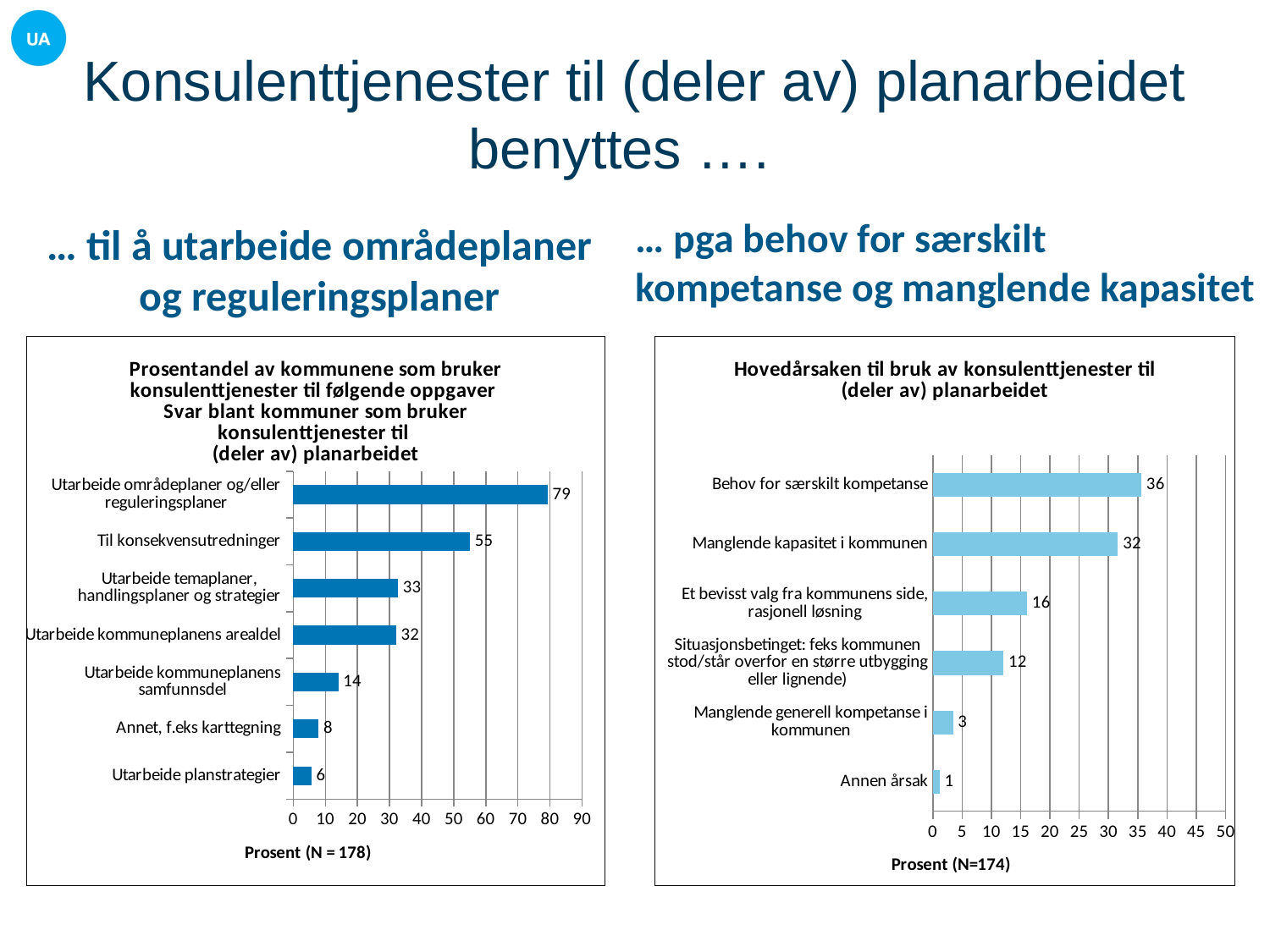
In the right chart, which category has the lowest value? Annen årsak What kind of chart is the right chart? Bar chart In the left chart, how many categories are shown? 7 In the right chart (Hovedårsaken til bruk av konsulenttjenester til (deler av) planarbeidet), what is the value for 'Manglende kapasitet i kommunen'? 32 In the left chart, which category has the lowest value? Utarbeide planstrategier In the right chart, which category has the highest value? Behov for særskilt kompetanse In the left chart, what is the value for 'Utarbeide kommuneplanens samfunnsdel'? 14 In the left chart (Prosentandel av kommunene som bruker konsulenttjenester til følgende oppgaver), what is the value for 'Til konsekvensutredninger'? 55 In the left chart, which category has the highest value? Utarbeide områdeplaner og/eller reguleringsplaner In the left chart, what is the difference between 'Utarbeide områdeplaner og/eller reguleringsplaner' and 'Til konsekvensutredninger'? 24 What is the x-axis label of the right chart? Prosent (N=174) In the right chart, which is larger: 'Et bevisst valg fra kommunens side, rasjonell løsning' or 'Situasjonsbetinget: feks kommunen stod/står overfor en større utbygging eller lignende)'? Et bevisst valg fra kommunens side, rasjonell løsning